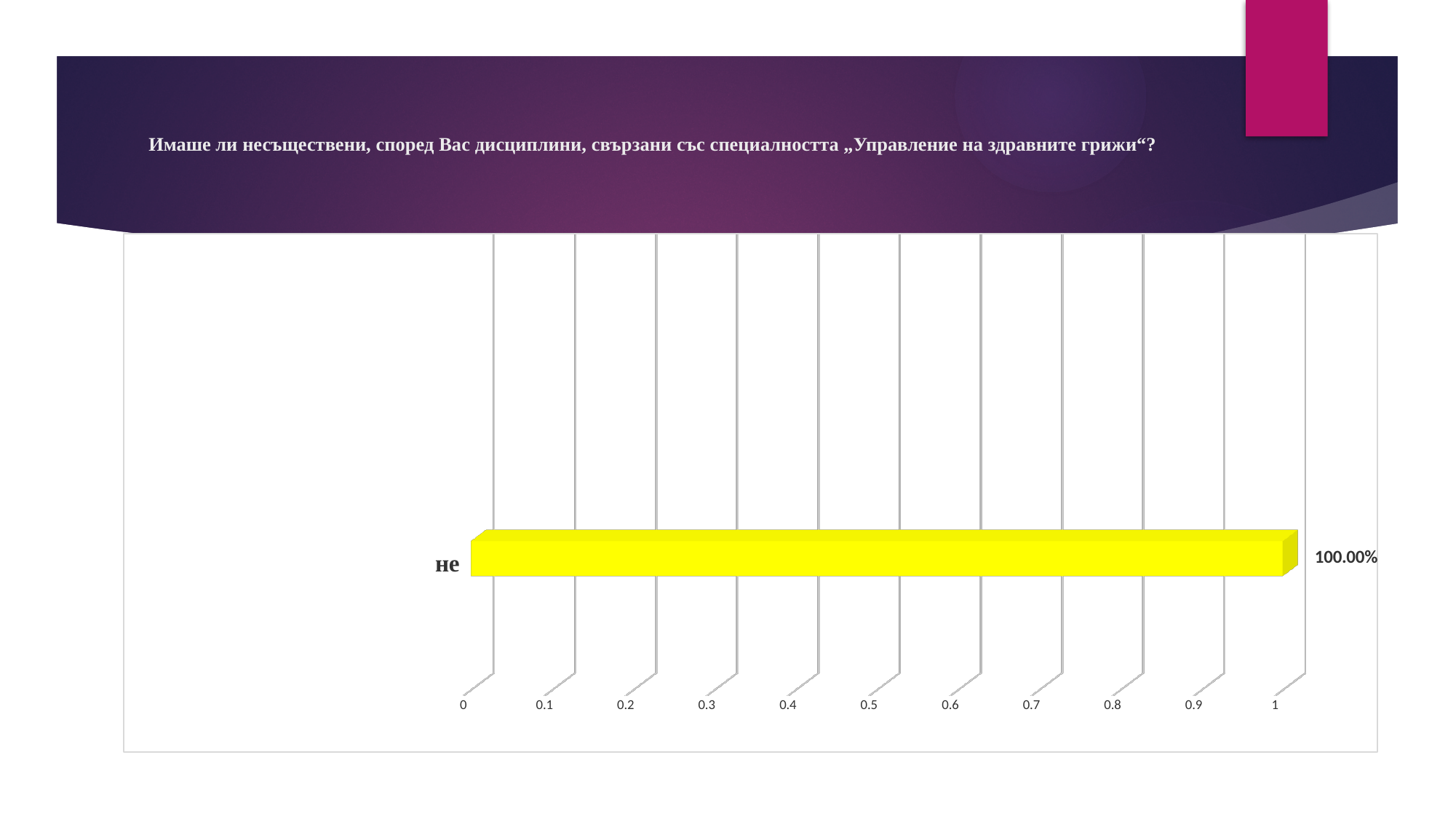
What kind of chart is shown on the slide? bar chart How many categories are plotted in the chart? 1 What colour is the bar in the chart? yellow Is the value for "не" greater or less than 0.5 on the axis? greater What is the highest value shown on the horizontal axis? 1 Which category has the highest value in the chart? не What is the value shown for the category "не"? 100.00% What is the label of the only category in the chart? не